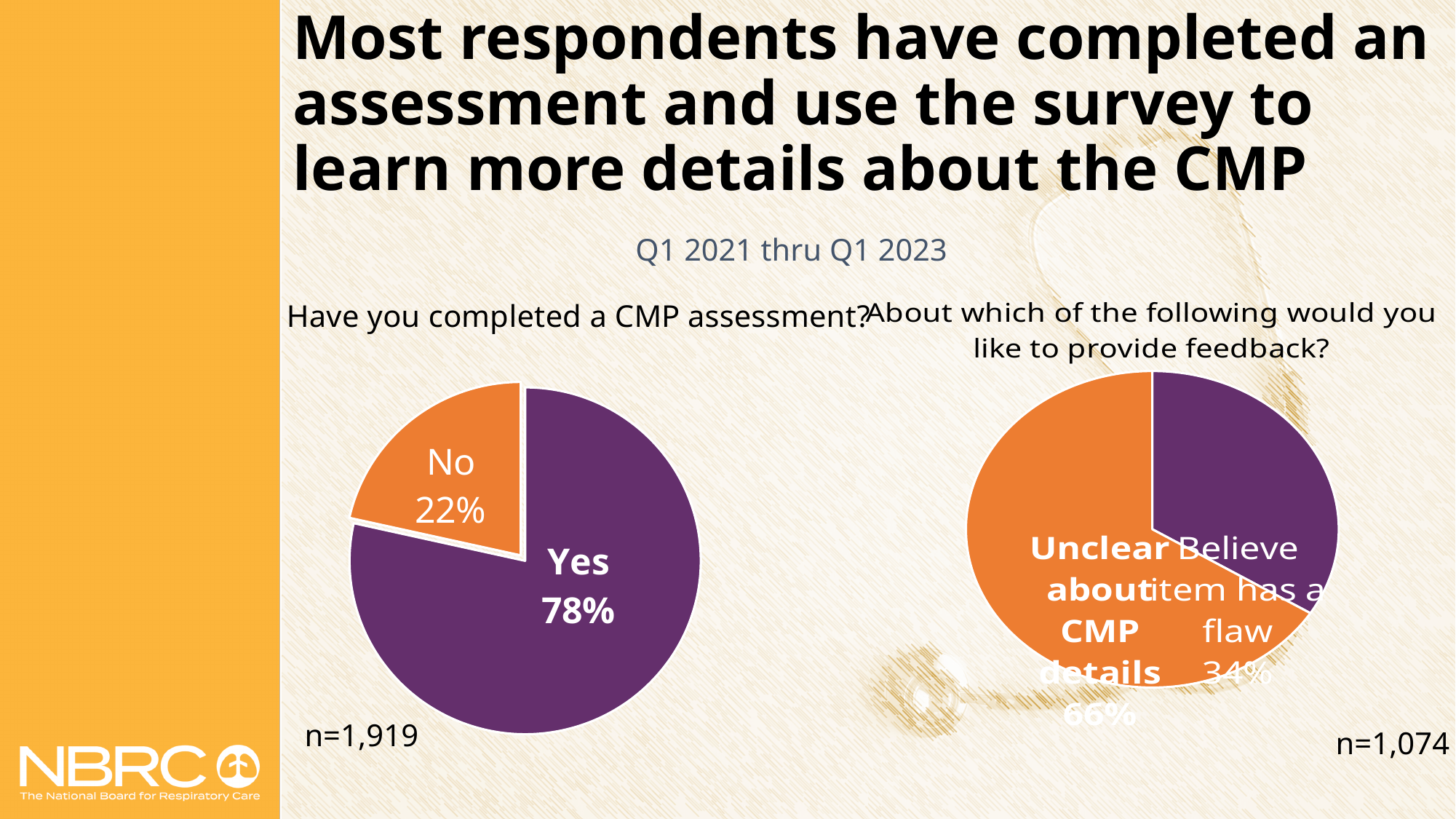
In the 'About which of the following would you like to provide feedback?' chart, which is larger: 'Unclear about CMP details' or 'Believe item has a flaw'? Unclear about CMP details What is the sample size (n) shown for the 'Have you completed a CMP assessment?' chart? n=1,919 In the 'Have you completed a CMP assessment?' chart, which response has the largest slice? Yes In the 'About which of the following would you like to provide feedback?' chart, what share chose 'Believe item has a flaw'? 34% In the 'About which of the following would you like to provide feedback?' chart, which option has the smallest slice? Believe item has a flaw In the 'Have you completed a CMP assessment?' chart, what percentage of respondents answered Yes? 78% In the 'About which of the following would you like to provide feedback?' chart, what share chose 'Unclear about CMP details'? 66% In the 'Have you completed a CMP assessment?' chart, what is the difference in percentage points between Yes and No? 56 In the 'Have you completed a CMP assessment?' chart, what percentage of respondents answered No? 22% What type of chart is used on the left side of the slide? Pie chart In the 'About which of the following would you like to provide feedback?' chart, what is the difference in percentage points between 'Unclear about CMP details' and 'Believe item has a flaw'? 32 How many slices does the 'Have you completed a CMP assessment?' pie chart have? 2